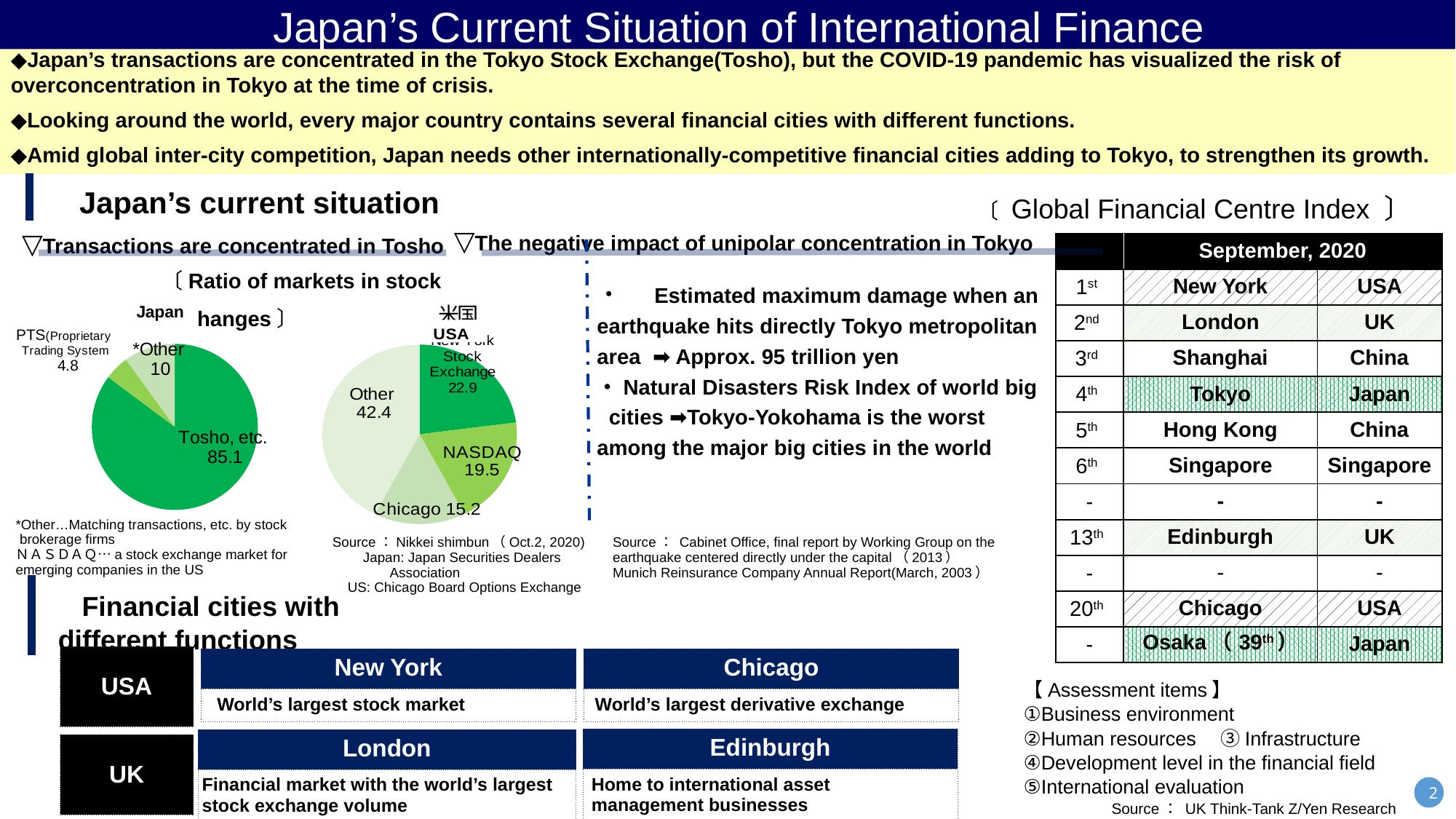
In the Japan pie chart, what is the value for *Other? 10 In the USA pie chart, what is the difference between the New York Stock Exchange value and the NASDAQ value? 3.4 How many slices does the USA pie chart have? 4 What type of chart is used to show the ratio of markets in stock exchanges for Japan? Pie chart In the USA pie chart, which named exchange slice is the smallest? Chicago In the USA pie chart, what is the value for Chicago? 15.2 In the USA pie chart, which slice is the largest? Other In the Japan pie chart, what is the value for Tosho, etc.? 85.1 In the USA pie chart, which is larger, New York Stock Exchange or Chicago? New York Stock Exchange In the Japan pie chart, which slice is the smallest? PTS In the USA pie chart, what is the value for NASDAQ? 19.5 In the Japan pie chart, what is the value for PTS (Proprietary Trading System)? 4.8